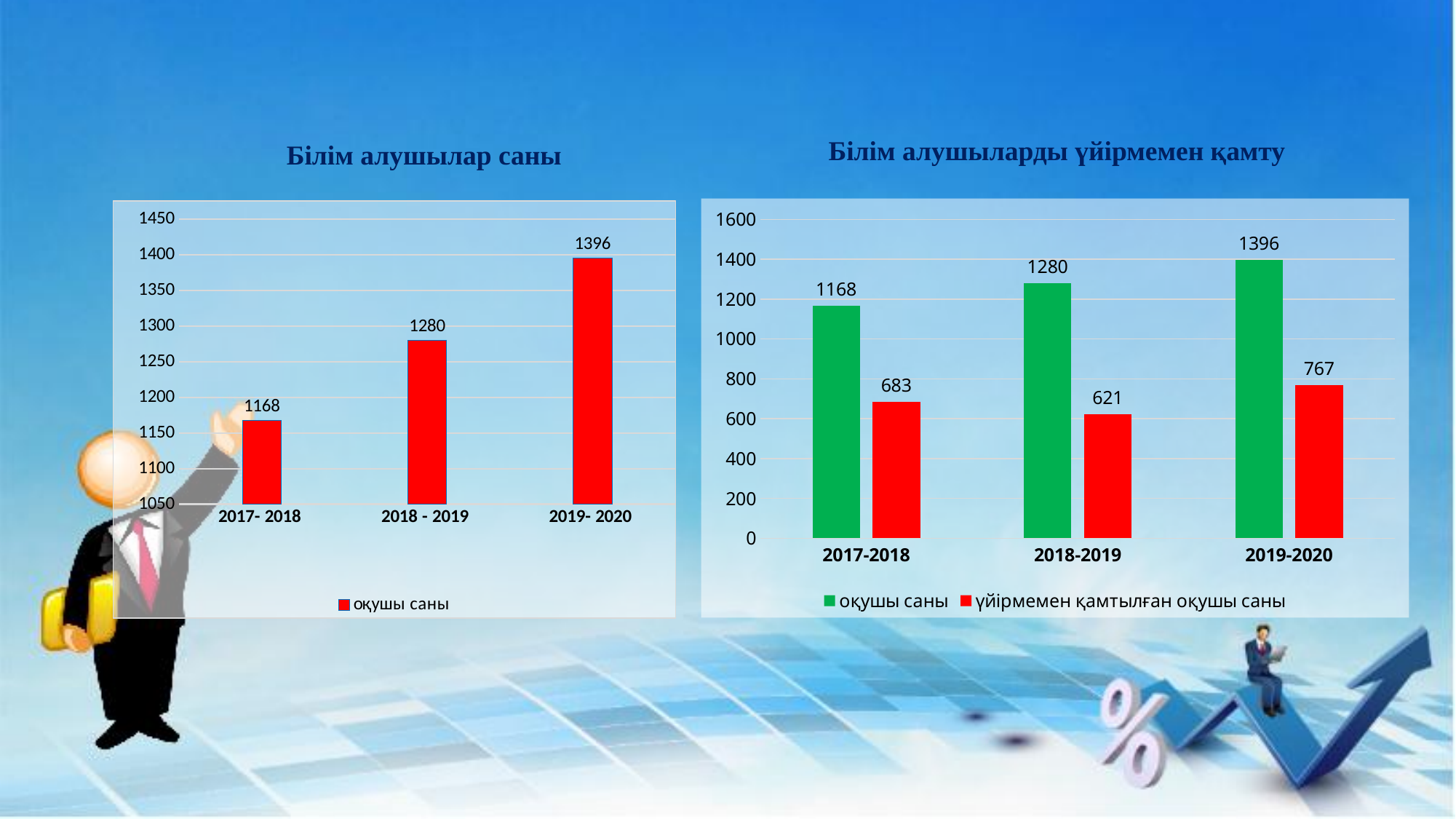
What kind of chart is the right chart 'Білім алушыларды үйірмемен қамту'? bar chart In the left chart 'Білім алушылар саны', what is the value for 2018 - 2019? 1280 In the right chart 'Білім алушыларды үйірмемен қамту', what is the value of 'үйірмемен қамтылған оқушы саны' for 2018-2019? 621 In the right chart 'Білім алушыларды үйірмемен қамту', what is the difference between 'оқушы саны' and 'үйірмемен қамтылған оқушы саны' for 2019-2020? 629 In the left chart 'Білім алушылар саны', what is the difference between the 2019- 2020 and 2017- 2018 values? 228 In the right chart 'Білім алушыларды үйірмемен қамту', which is larger: 'үйірмемен қамтылған оқушы саны' for 2017-2018 or for 2019-2020? 2019-2020 In the left chart 'Білім алушылар саны', how many categories are shown on the x axis? 3 In the right chart 'Білім алушыларды үйірмемен қамту', what colour are the bars for 'оқушы саны'? green In the left chart 'Білім алушылар саны', which year has the highest value? 2019- 2020 In the right chart 'Білім алушыларды үйірмемен қамту', how many series does the legend list? 2 In the left chart 'Білім алушылар саны', do the values rise or fall from 2017- 2018 to 2019- 2020? rise In the right chart 'Білім алушыларды үйірмемен қамту', which year has the lowest value for 'үйірмемен қамтылған оқушы саны'? 2018-2019